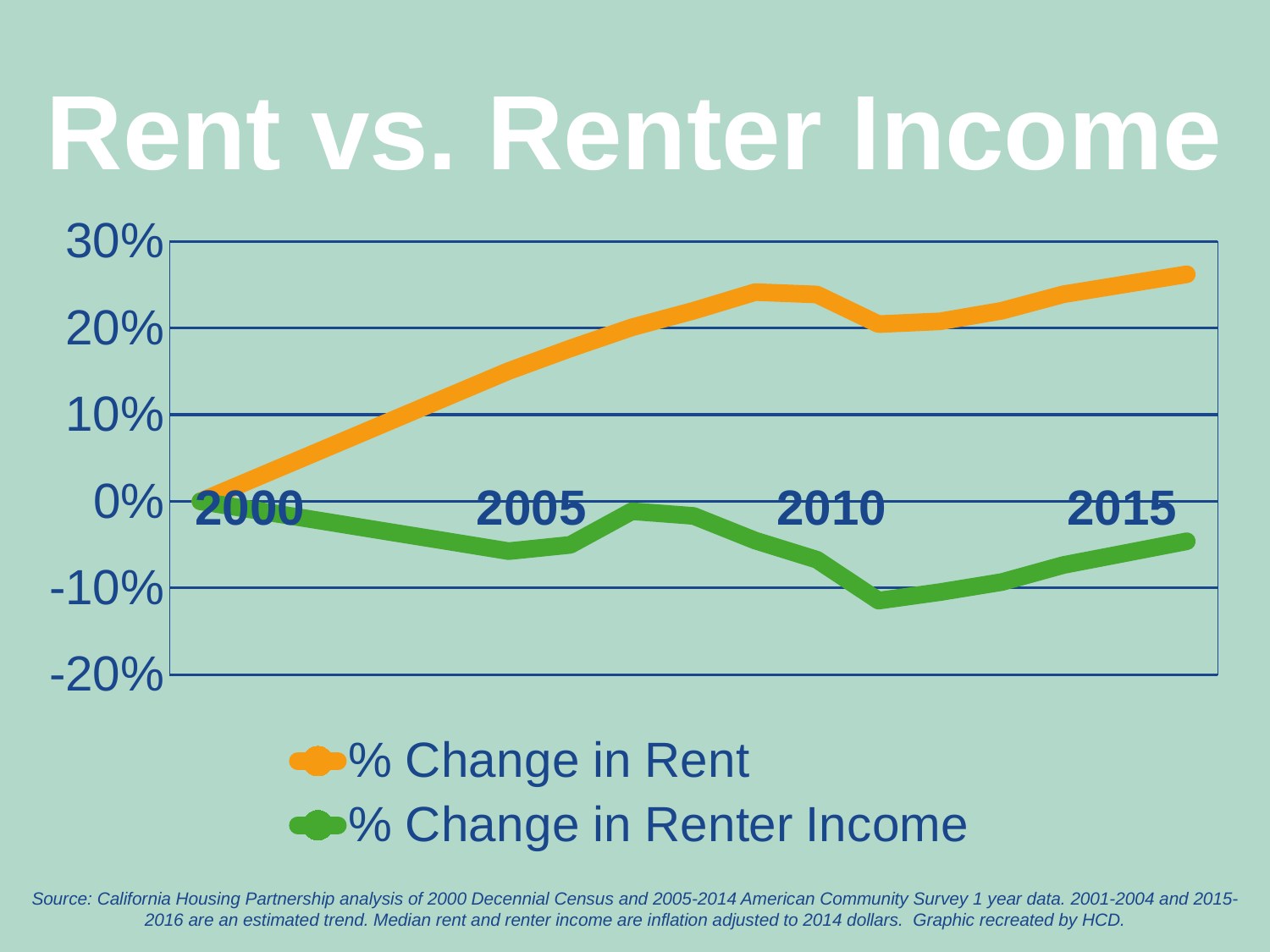
In 2015, which series has the larger value, % Change in Rent or % Change in Renter Income? % Change in Rent Which colour is used for the % Change in Rent series? orange Is the value for % Change in Renter Income in 2015 greater or less than 0%? less How many series does the legend list? 2 What is the title of the chart? Rent vs. Renter Income What is the value of % Change in Renter Income in 2000? 0% Is the value for % Change in Rent in 2010 greater or less than 20%? greater Is the value for % Change in Rent in 2005 greater or less than 10%? greater Does the % Change in Rent series generally rise or fall from 2000 to 2015? rise What is the value of % Change in Rent in 2000? 0% What kind of chart is shown on the slide? line chart